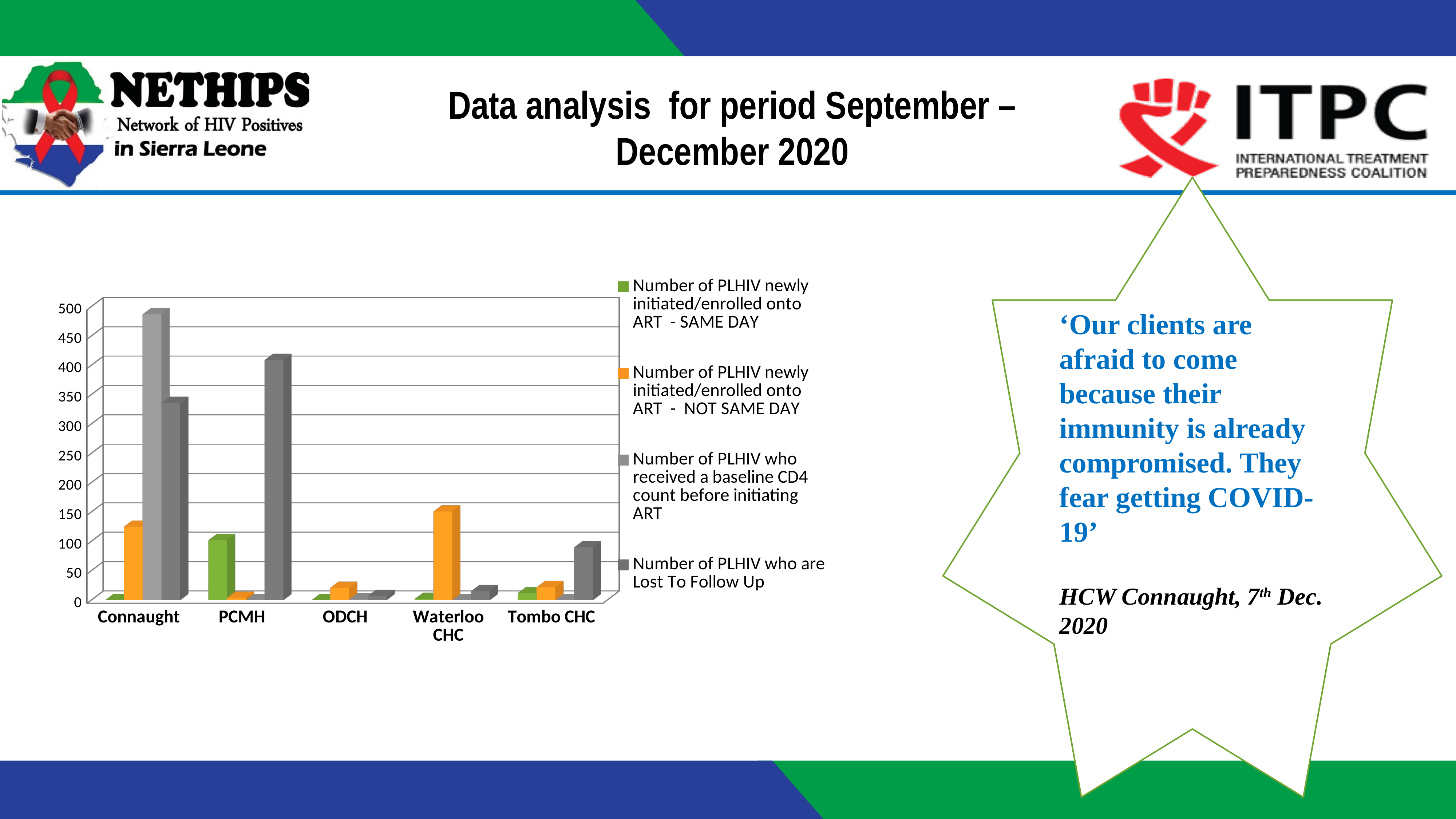
How many series does the chart legend list? 4 Is the number of PLHIV newly initiated/enrolled onto ART - NOT SAME DAY at Waterloo CHC greater or less than 100? greater Which facility has the highest number of PLHIV who are Lost To Follow Up? PCMH Which facility has the highest number of PLHIV who received a baseline CD4 count before initiating ART? Connaught What kind of chart is shown on the slide? bar chart Is the number of PLHIV who received a baseline CD4 count before initiating ART at Connaught greater or less than 450? greater Is the number of PLHIV who are Lost To Follow Up at Tombo CHC greater or less than 150? less Which facility has the highest number of PLHIV newly initiated/enrolled onto ART - NOT SAME DAY? Waterloo CHC At Connaught, which is larger: the number of PLHIV who received a baseline CD4 count before initiating ART or the number of PLHIV who are Lost To Follow Up? Number of PLHIV who received a baseline CD4 count before initiating ART How many facilities are shown on the x axis of the chart? 5